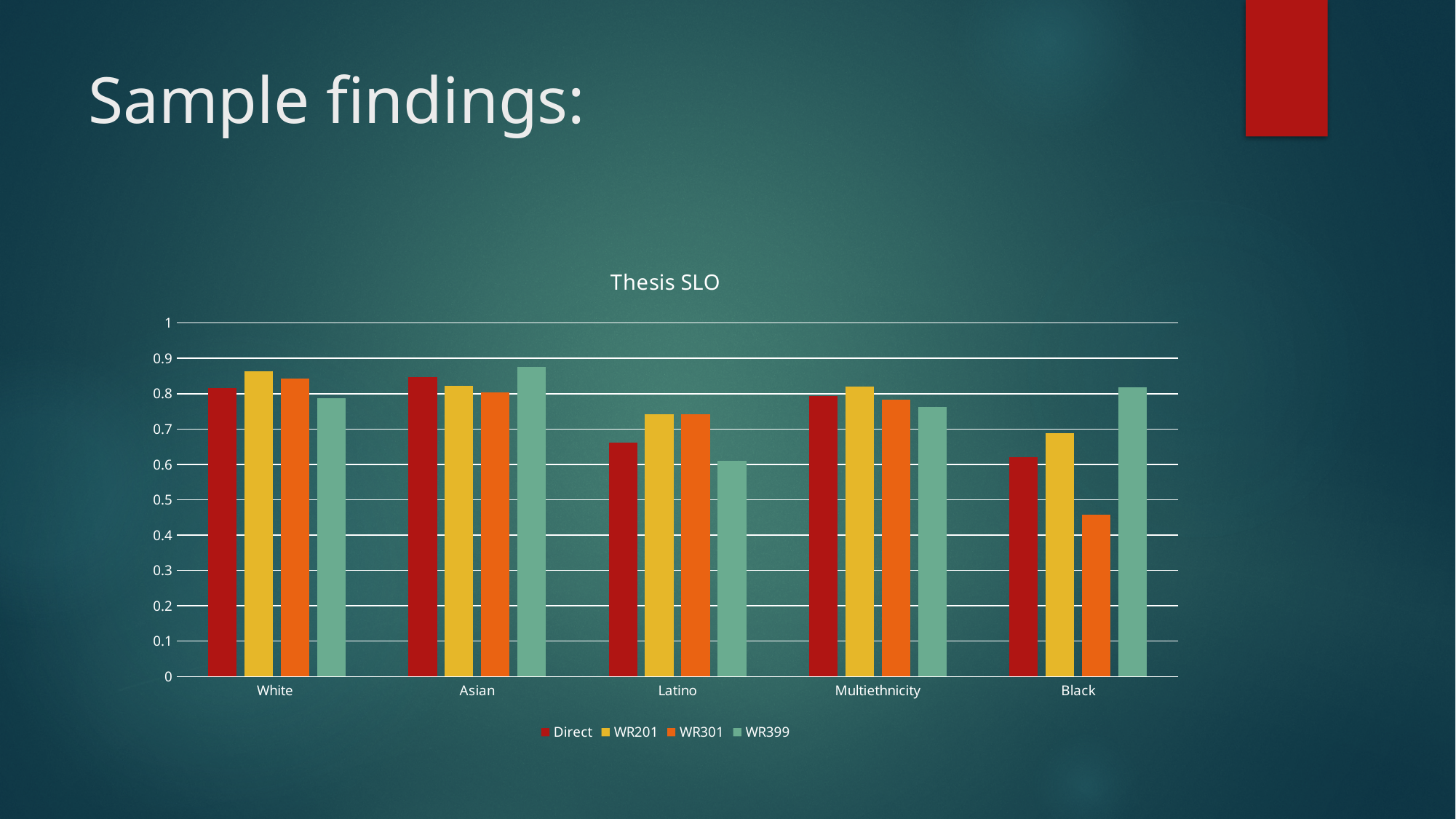
For Black, which is larger: the WR399 value or the WR301 value? WR399 Is the WR399 value for Black greater or less than 0.7? greater Which category has the lowest WR301 value? Black How many categories are shown on the x axis? 5 Is the WR301 value for Black greater or less than 0.5? less For Latino, which is larger: the Direct value or the WR201 value? WR201 Is the Direct value for Latino greater or less than 0.7? less What kind of chart is shown on the slide? bar chart What is the title of the chart? Thesis SLO Which category has the lowest WR399 value? Latino How many series does the legend list? 4